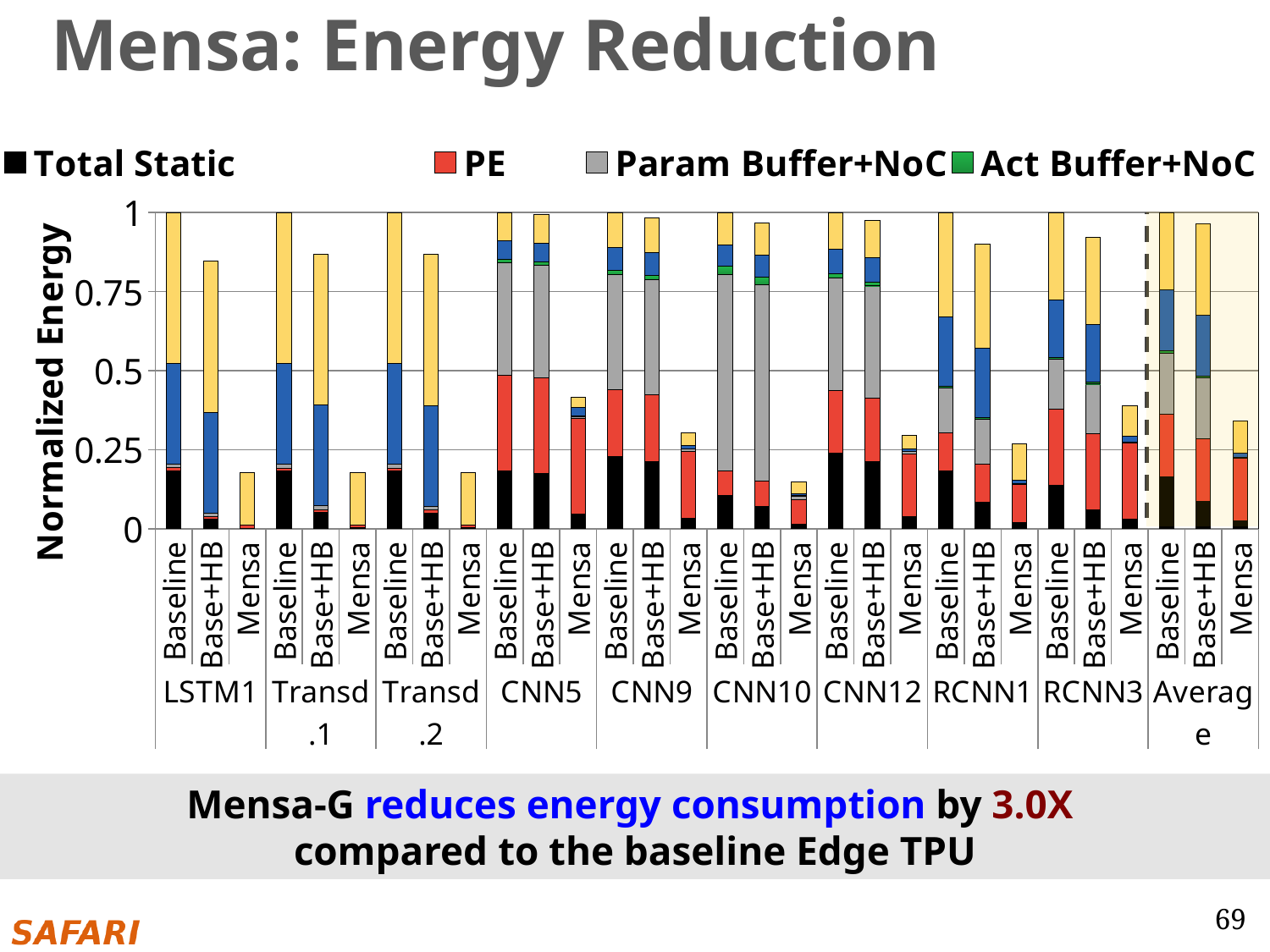
What is the label of the y axis? Normalized Energy Is the total value of the Mensa bar for Average greater or less than 0.25? greater What type of chart is shown on the slide? Stacked bar chart Is the total value of the Mensa bar for CNN5 greater or less than 0.5? less How many workload groups are shown along the x axis? 10 Which is larger: the total of the Mensa bar for CNN5 or the Mensa bar for LSTM1? Mensa bar for CNN5 Is the total value of the Base+HB bar for LSTM1 greater or less than 0.75? greater Which is larger: the total of the Base+HB bar for CNN5 or the Base+HB bar for LSTM1? Base+HB bar for CNN5 What is the total normalized energy of the Baseline bar for LSTM1? 1